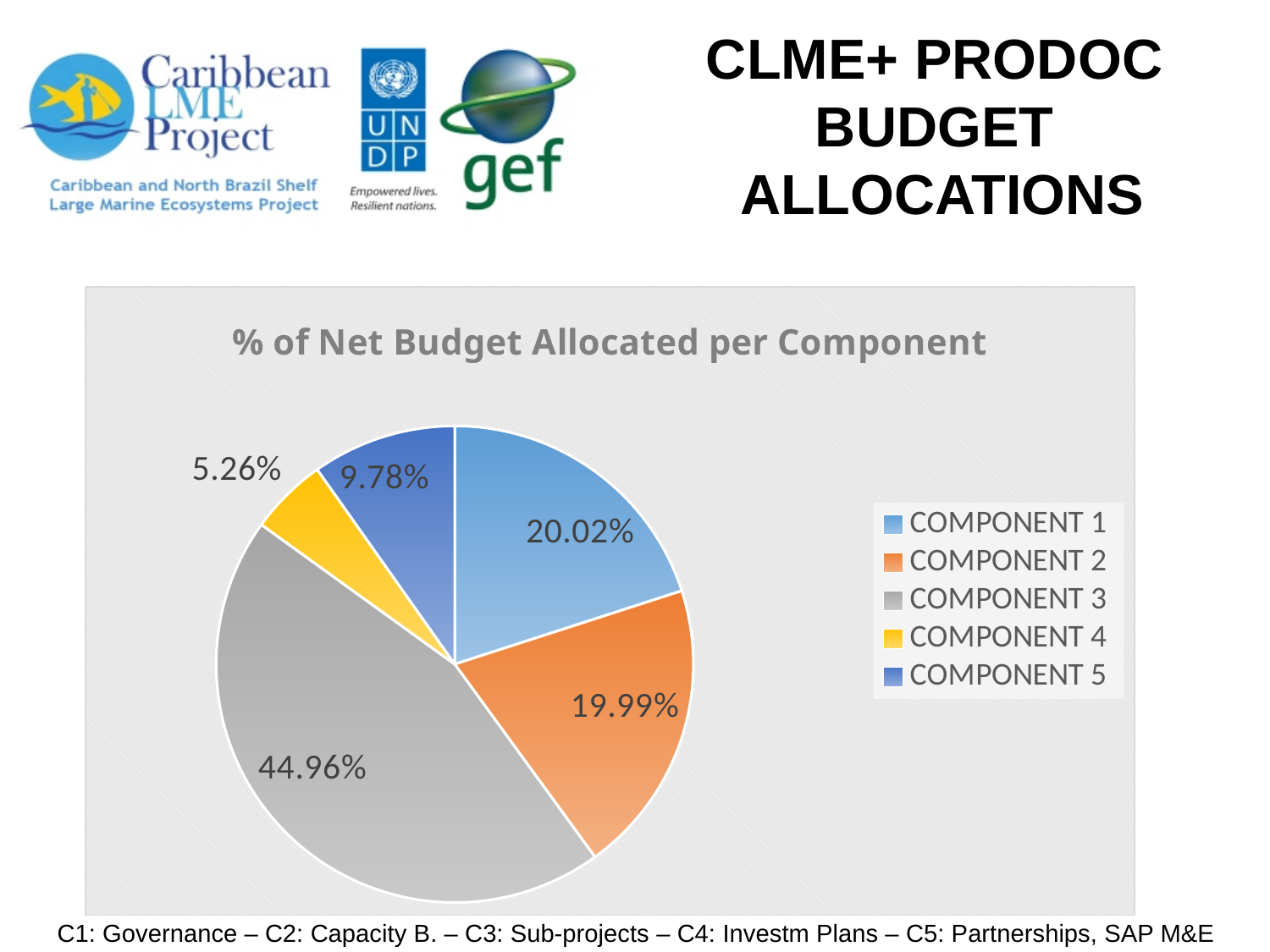
What share of the pie does Component 2 represent? 19.99% Which component receives the largest share of the net budget? Component 3 What percentage of the net budget is allocated to Component 3? 44.96% What is the difference in percentage points between Component 3 and Component 1? 24.94% Which has a larger share of the budget, Component 5 or Component 4? Component 5 What share of the pie does Component 4 represent? 5.26% What type of chart is shown on the slide? pie chart What is the title of the chart? % of Net Budget Allocated per Component Which component receives the smallest share of the net budget? Component 4 What percentage of the net budget is allocated to Component 1? 20.02% How many components are shown in the pie chart? 5 What percentage of the net budget is allocated to Component 5? 9.78%